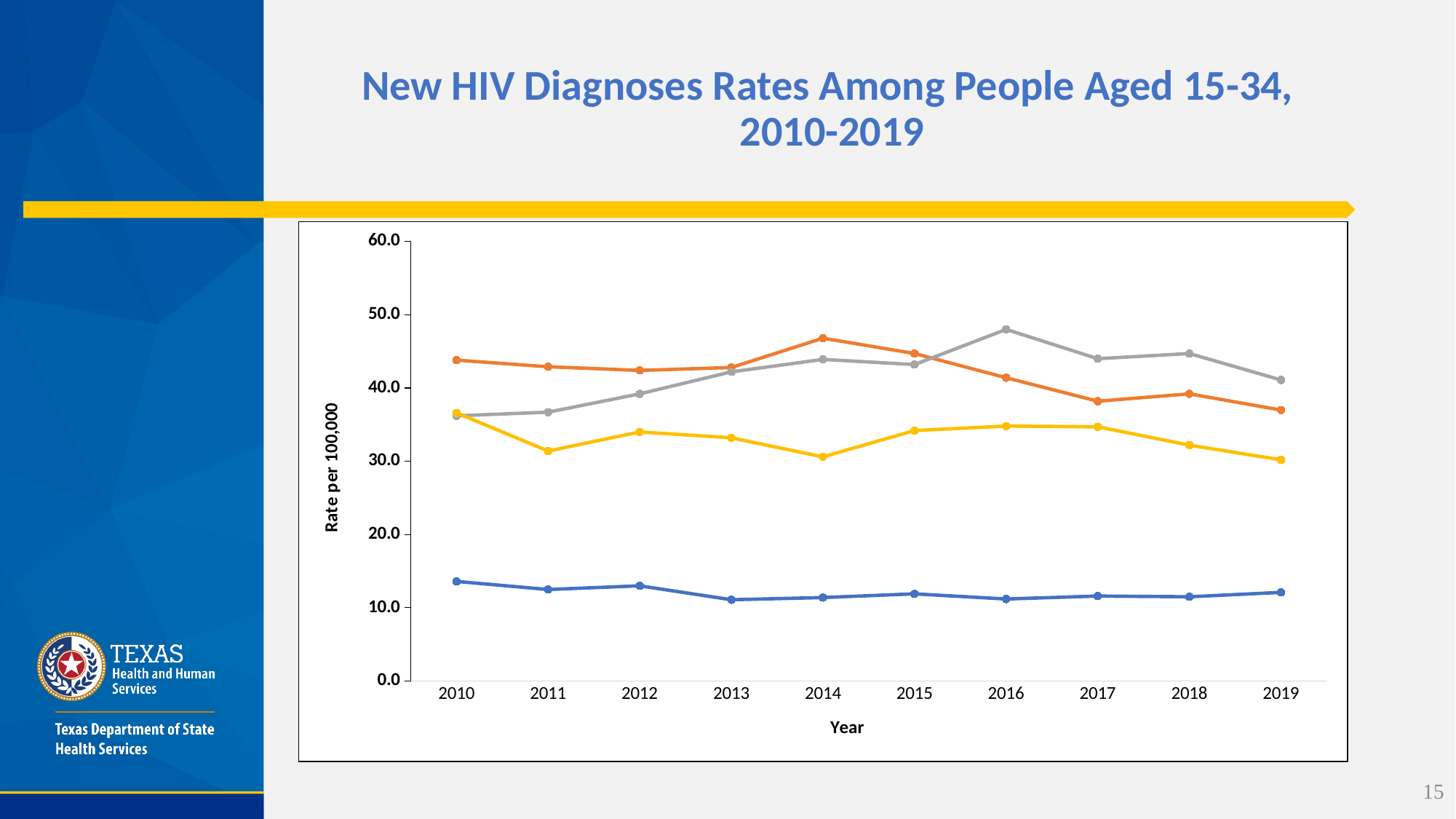
How many lines are plotted on the chart? 4 Is the value of the orange line in 2014 greater or less than 40.0? greater Is the value of the gray line in 2016 greater or less than 40.0? greater What kind of chart is shown on the slide? Line chart What is the label on the y axis of the chart? Rate per 100,000 Does the orange line rise or fall from 2014 to 2019? Fall In 2019, which line has the higher value, the gray line or the orange line? Gray line How many years are shown along the x axis of the chart? 10 Is the value of the blue line in 2010 greater or less than 20.0? less In which year does the gray line reach its highest value? 2016 In 2010, which line has the higher value, the orange line or the gray line? Orange line